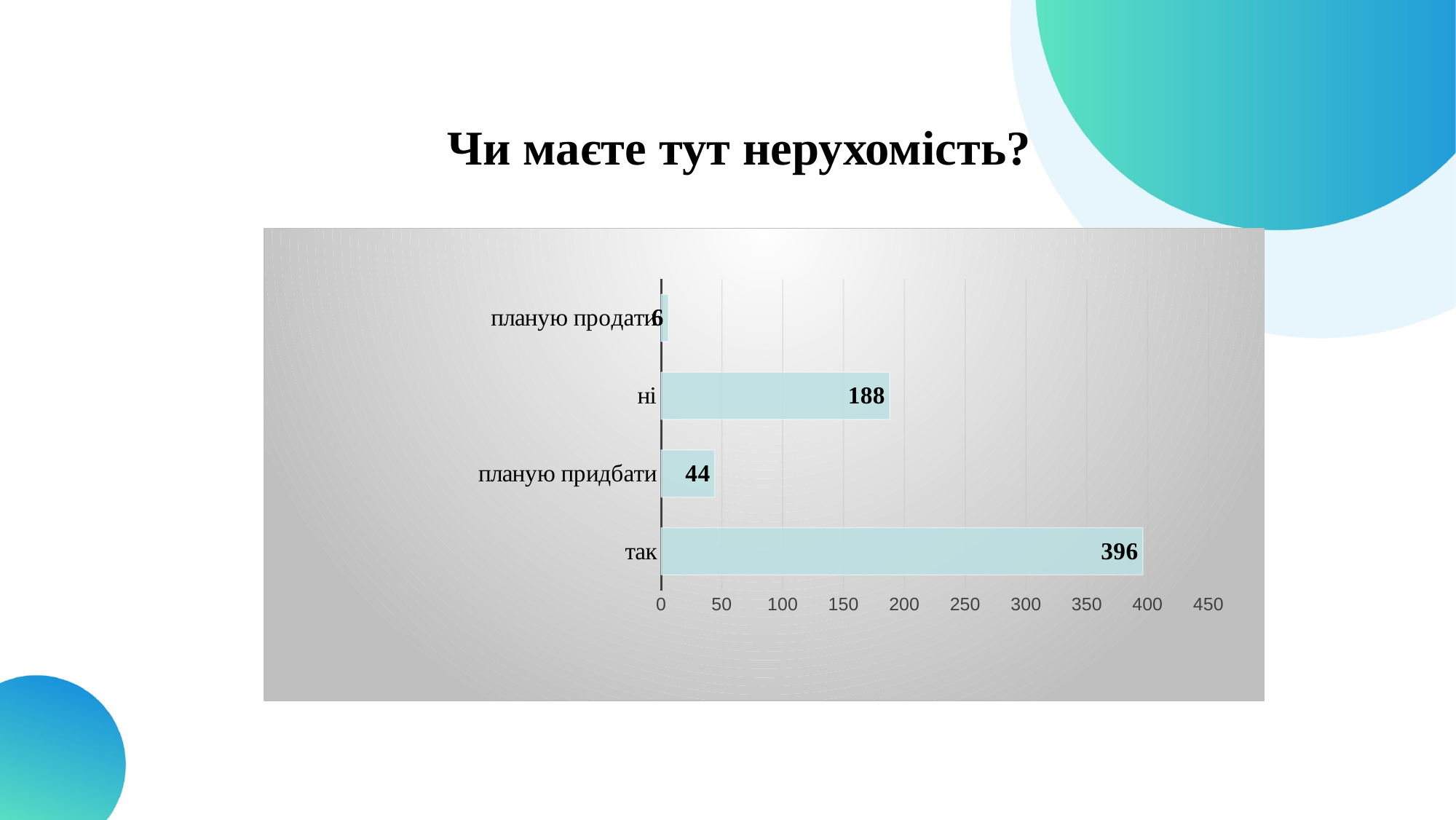
What is the difference between the values for "планую придбати" and "планую продати"? 38 What is the value for "так"? 396 Which category has the lowest value? планую продати What is the value for "планую продати"? 6 What is the value for "ні"? 188 What is the value for "планую придбати"? 44 Which is larger, the value for "ні" or the value for "планую придбати"? ні What kind of chart is shown on the slide? bar chart What is the difference between the values for "так" and "ні"? 208 What is the title of the slide? Чи маєте тут нерухомість? Which category has the highest value? так How many categories are shown in the chart? 4